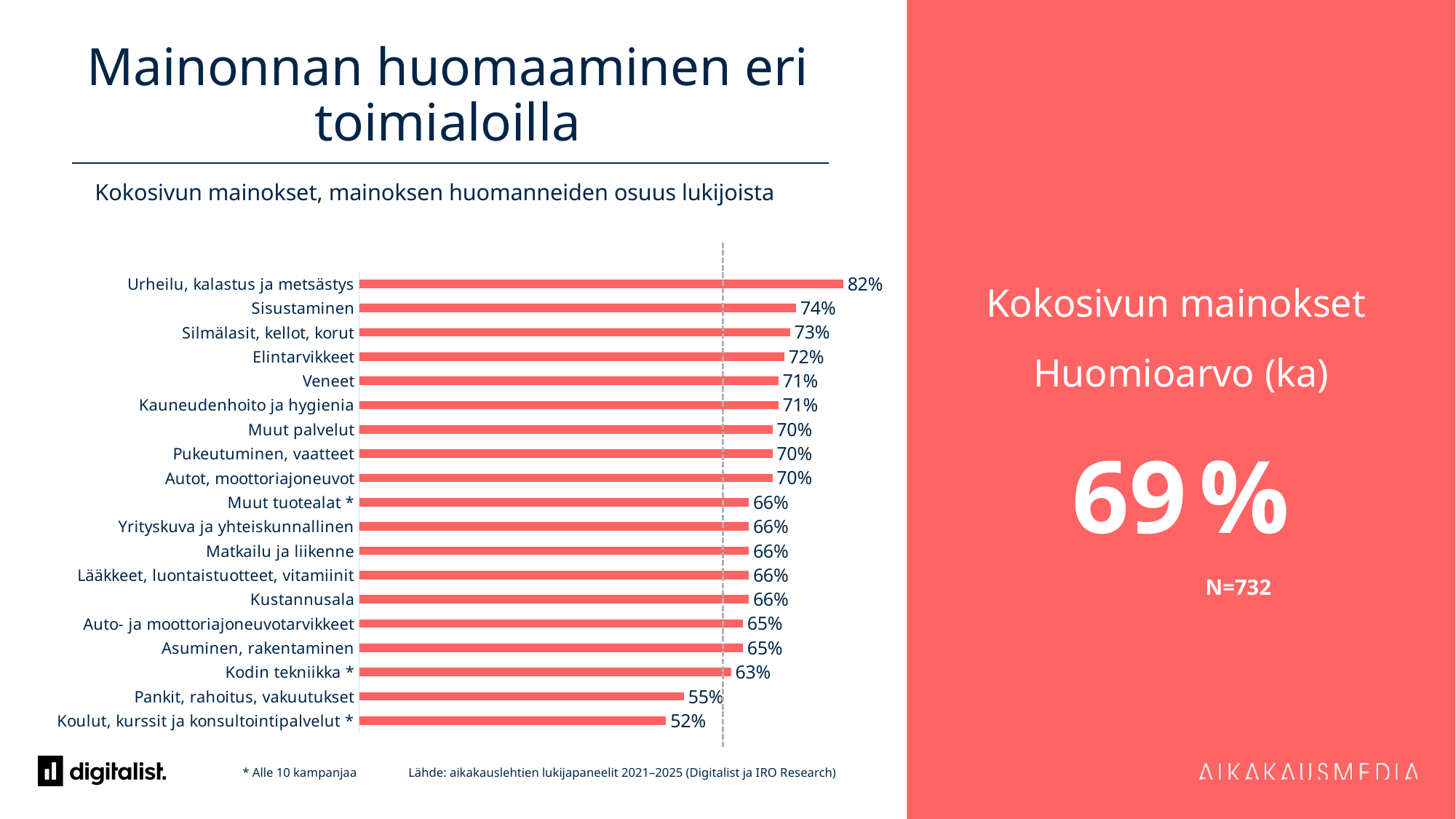
How many categories are shown in the chart? 19 What kind of chart is shown on the slide? Bar chart What is the value for Urheilu, kalastus ja metsästys? 82% Which is larger, the value for Veneet or the value for Matkailu ja liikenne? Veneet What is the value for Elintarvikkeet? 72% What is the difference between the values for Urheilu, kalastus ja metsästys and Koulut, kurssit ja konsultointipalvelut *? 30 percentage points What is the value for Pankit, rahoitus, vakuutukset? 55% Which category has the lowest value? Koulut, kurssit ja konsultointipalvelut * What is the difference between the values for Sisustaminen and Pankit, rahoitus, vakuutukset? 19 percentage points What is the average (ka) Huomioarvo for Kokosivun mainokset shown on the right panel? 69 % Which category has the highest value? Urheilu, kalastus ja metsästys What is the value for Kodin tekniikka *? 63%